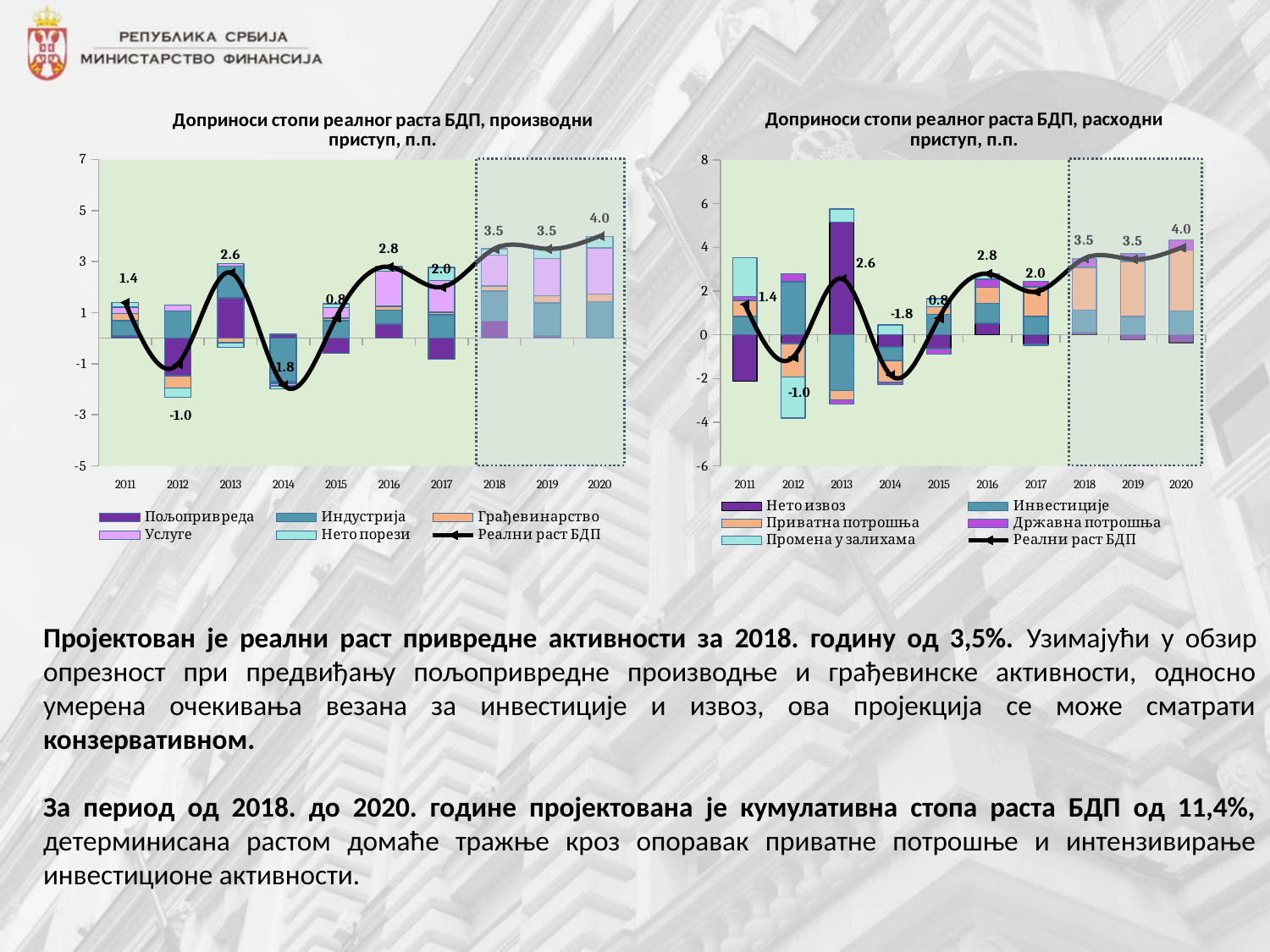
In the right chart (расходни приступ), does the real GDP growth line rise or fall from 2018 to 2020? Rise In the left chart (производни приступ), what is the difference between the real GDP growth values labelled for 2020 and 2018? 0.5 In the left chart (производни приступ), which year has the lowest labelled real GDP growth value? 2014 In the left chart (производни приступ), what is the real GDP growth (Реални раст БДП) value labelled for 2013? 2.6 How many entries does the legend of the right chart (расходни приступ) list? 6 In the right chart (расходни приступ), what is the real GDP growth value labelled for 2014? -1.8 In the right chart (расходни приступ), what is the difference between the real GDP growth values labelled for 2013 and 2012? 3.6 What kind of chart is the left chart (производни приступ)? A stacked bar chart with a line In the right chart (расходни приступ), is the labelled real GDP growth value higher in 2016 or in 2017? 2016 In the left chart (производни приступ), what is the real GDP growth value labelled for 2020? 4.0 In the right chart (расходни приступ), which year has the highest labelled real GDP growth value? 2020 How many years are shown on the x axis of the left chart (производни приступ)? 10